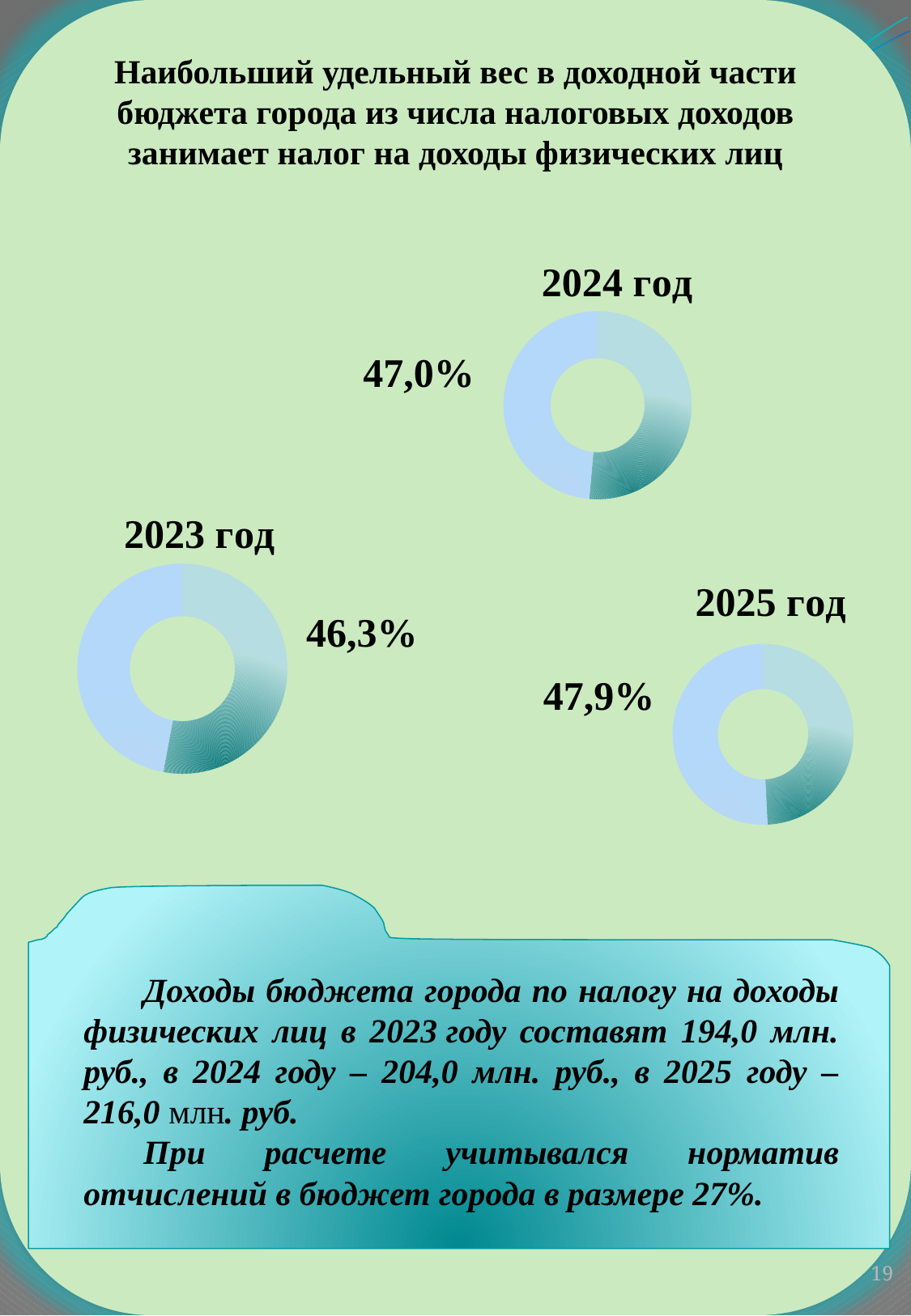
What is the difference between the share shown for 2025 год and the share shown for 2023 год? 1,6 percentage points How many doughnut charts are on the slide? 3 What kind of chart is used for each year on the slide? Doughnut chart What share is shown for the 2025 год chart? 47,9% What share is shown for the 2024 год chart? 47,0% Do the shares rise or fall from 2023 год to 2025 год? Rise Does the share shown for 2023 год exceed 50%? No What is the difference between the share shown for 2024 год and the share shown for 2023 год? 0,7 percentage points Which year's chart shows the highest share? 2025 год Which year's chart shows the lowest share? 2023 год Which is larger, the share for 2024 год or the share for 2025 год? 2025 год What share is shown for the 2023 год chart? 46,3%